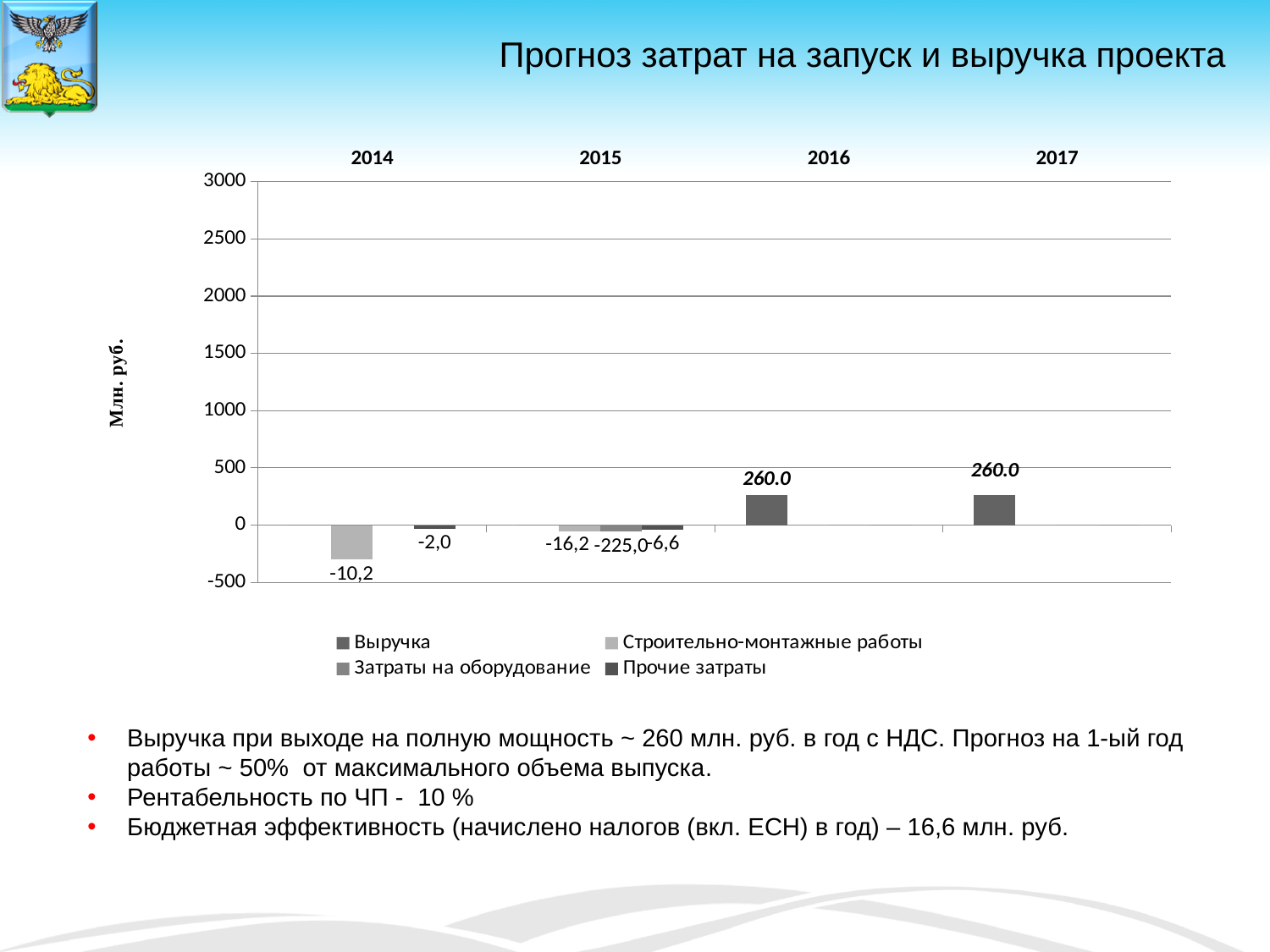
What is the lowest value shown on the vertical axis of the chart? -500 In which years does the chart show a positive Выручка bar? 2016 and 2017 What is the value of Выручка in 2017? 260.0 How many years are shown along the x axis of the chart? 4 How many series does the chart legend list? 4 What is the highest value shown on the vertical axis of the chart? 3000 What is the label on the vertical axis of the chart? Млн. руб. What is the title of the slide containing the chart? Прогноз затрат на запуск и выручка проекта What is the value of Выручка in 2016? 260.0 Is the value of Выручка in 2016 greater or less than 500? less Is the value of Выручка in 2017 greater or less than 0? greater What type of chart is shown on the slide? bar chart